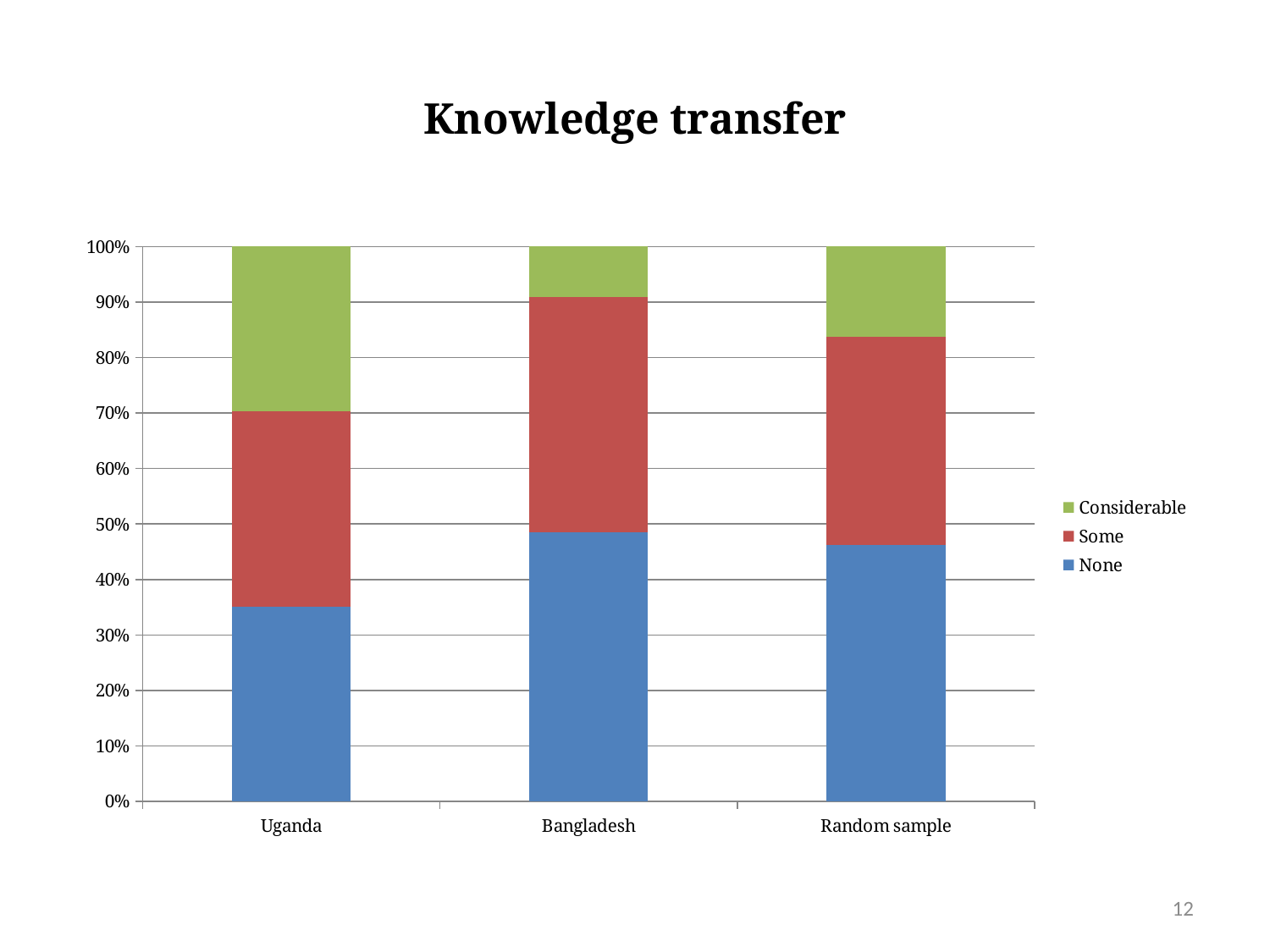
How many categories are shown on the x axis? 3 What is the title of the chart? Knowledge transfer What is the total height of the Uganda stacked bar? 100% Is the Considerable segment larger for Uganda or for Bangladesh? Uganda Which category has the smallest None segment? Uganda Which category has the largest Considerable segment? Uganda Is the None value for Bangladesh greater or less than 40%? greater Which category has the smallest Considerable segment? Bangladesh Is the None value for Uganda greater or less than 40%? less How many series does the legend list? 3 Which series is shown in green in the legend? Considerable What kind of chart is shown on the slide? Stacked bar chart